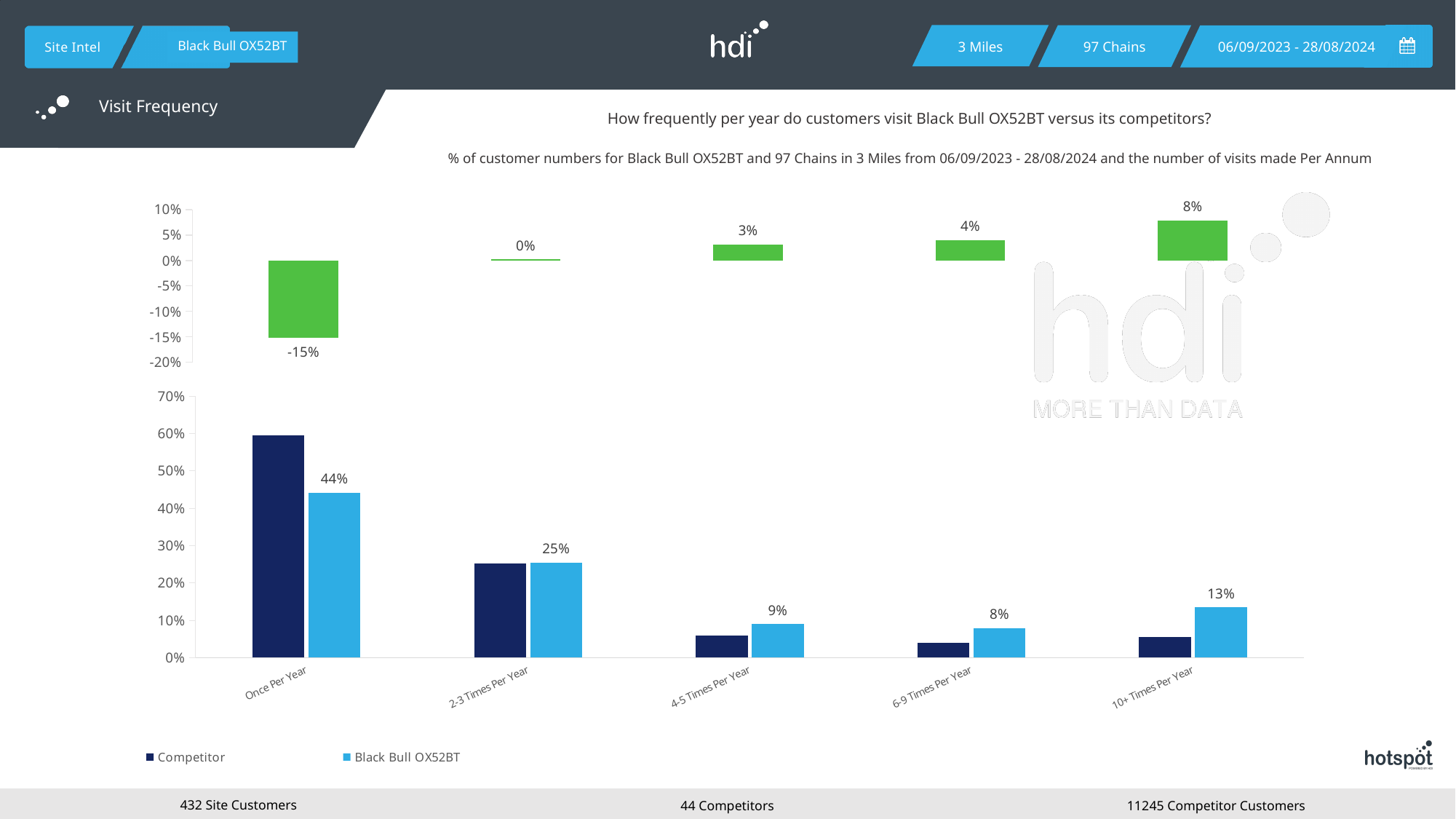
In the top chart, what is the value shown for Once Per Year? -15% In the bottom chart, what percentage of Black Bull OX52BT customers visit Once Per Year? 44% In the bottom chart, what is the difference between the Black Bull OX52BT values for Once Per Year and 2-3 Times Per Year? 19% In the top chart, which category has the lowest value? Once Per Year In the bottom chart, what is the Black Bull OX52BT value for 2-3 Times Per Year? 25% In the bottom chart, which visit frequency category has the highest Black Bull OX52BT value? Once Per Year In the bottom chart, what is the Black Bull OX52BT value for 10+ Times Per Year? 13% How many visit frequency categories are shown on the x axis of the bottom chart? 5 In the bottom chart, is the Competitor value for 6-9 Times Per Year greater or less than 10%? less In the bottom chart, is the Competitor value for Once Per Year greater or less than 50%? greater How many series does the legend of the bottom chart list? 2 In the top chart, what is the value shown for 10+ Times Per Year? 8%